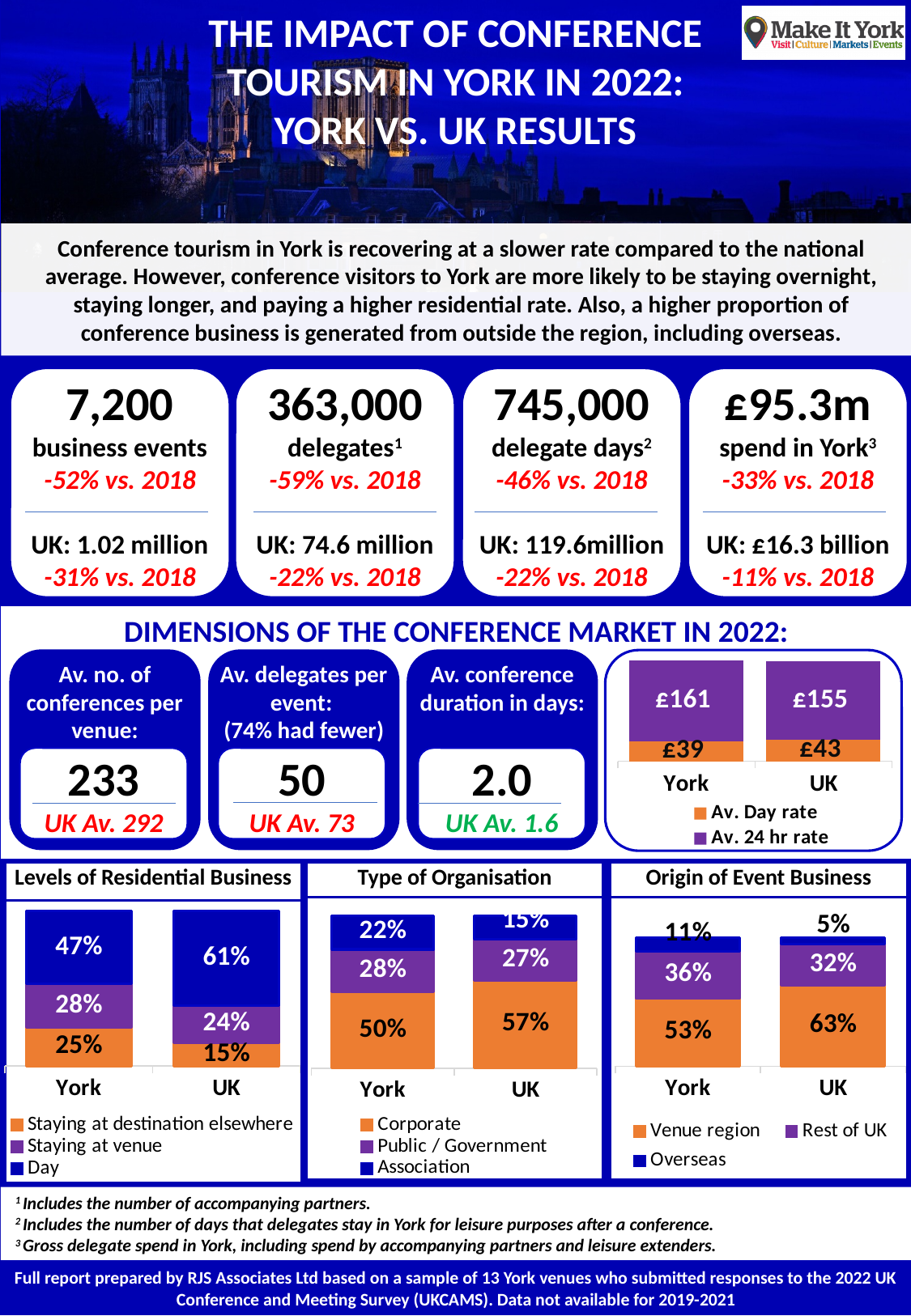
In the 'Origin of Event Business' chart, what is the UK value for 'Overseas'? 5% In the rate chart in the 'Dimensions of the Conference Market' section, which has the higher 'Av. Day rate': York or UK? UK In the 'Levels of Residential Business' chart, what is the difference between the York and UK values for 'Staying at destination elsewhere'? 10% In the 'Type of Organisation' chart, what is the York value for 'Corporate'? 50% In the 'Levels of Residential Business' chart, what is the UK value for 'Staying at venue'? 24% In the 'Type of Organisation' chart, which is larger for 'Association': York or UK? York What type of chart is the 'Levels of Residential Business' chart? Stacked bar chart In the 'Origin of Event Business' chart, what is the difference between the UK and York values for 'Venue region'? 10% In the 'Levels of Residential Business' chart, what percentage of York conference visitors are 'Day' visitors? 47% In the 'Origin of Event Business' chart, which segment is the largest for York? Venue region In the rate chart in the 'Dimensions of the Conference Market' section, what is the 'Av. 24 hr rate' for York? £161 How many series does the legend of the 'Type of Organisation' chart list? 3